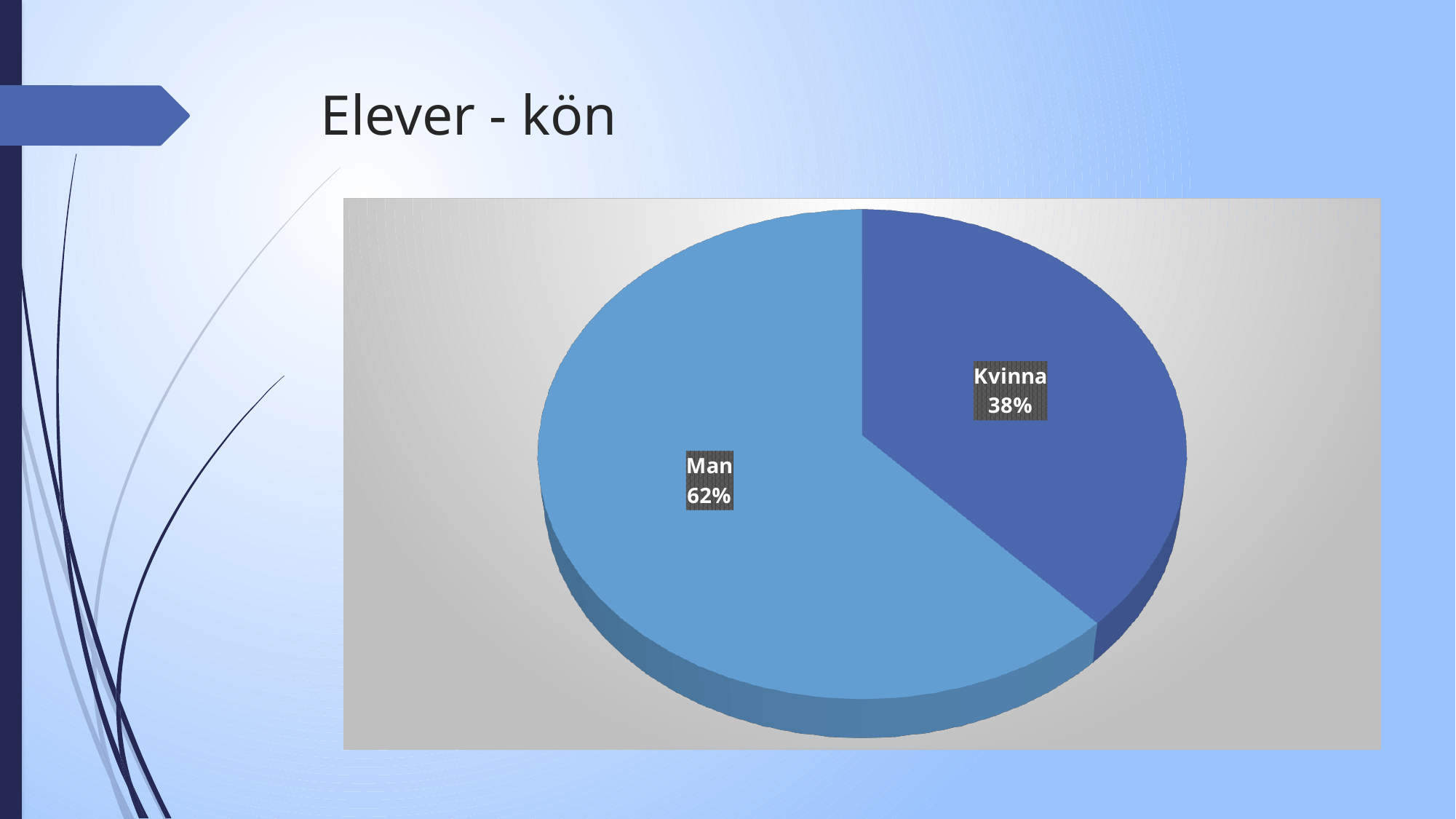
Which slice is the smallest? Kvinna Is the share for Man greater or less than 50%? greater Which slice is the largest? Man What kind of chart is shown on the slide? pie chart What is the difference in percentage points between Man and Kvinna? 24 percentage points Is the share for Kvinna greater or less than 50%? less What share of the pie does Man represent? 62% What share of the pie does Kvinna represent? 38% Which slice is shown in the darker blue colour? Kvinna Which is larger, Man or Kvinna? Man What is the title of the slide containing the pie chart? Elever - kön How many slices does the pie chart have? 2